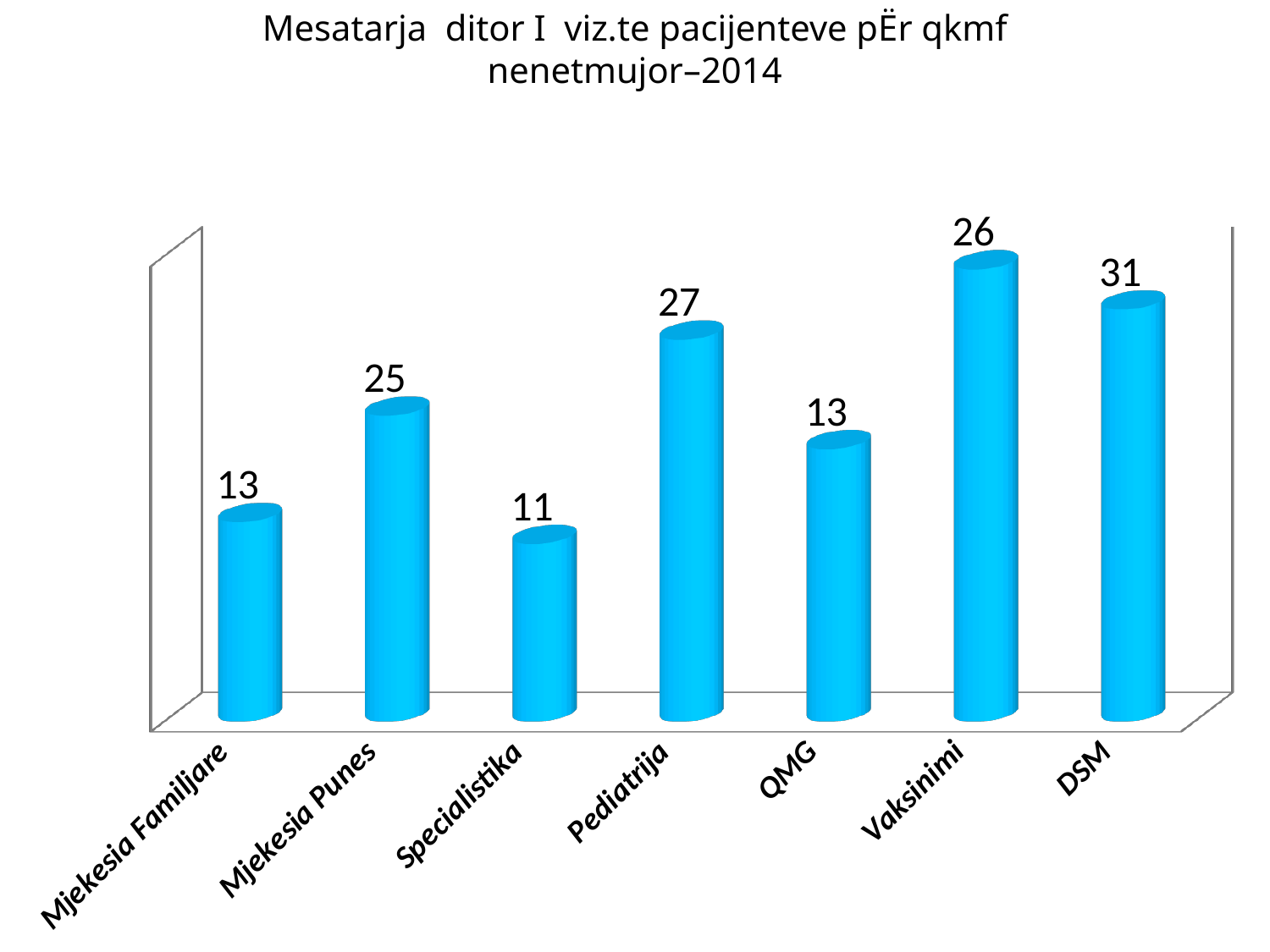
What kind of chart is this? bar chart What is the value for Mjekesia Punes? 25 What is the value for Pediatrija? 27 What is the value for Vaksinimi? 26 Which is larger, the value for Vaksinimi or the value for QMG? Vaksinimi What is the difference between the values for Pediatrija and Mjekesia Punes? 2 Which two categories share the same value of 13? Mjekesia Familjare and QMG What year is mentioned in the chart title? 2014 Which category has the lowest value? Specialistika What is the difference between the values for DSM and Specialistika? 20 How many categories are shown on the x axis? 7